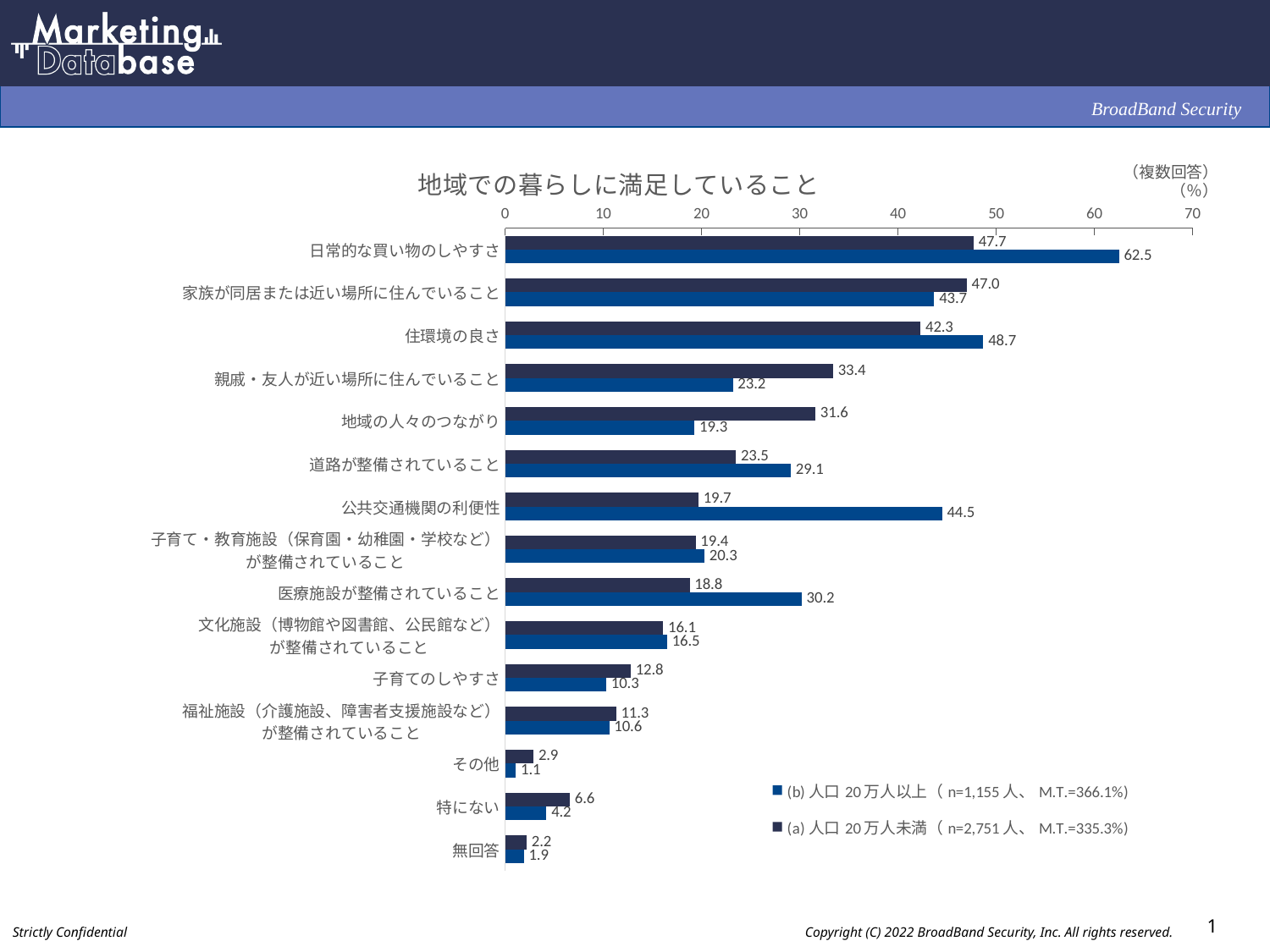
What are the two values shown for 住環境の良さ? 42.3 and 48.7 What is the difference between the two values shown for 日常的な買い物のしやすさ? 14.8 What is the sample size (n) given in the legend for (b) 人口20万人以上? 1,155人 How many series does the legend list? 2 Is the larger of the two values for 親戚・友人が近い場所に住んでいること greater or less than 30? greater Which category has the highest value on the chart? 日常的な買い物のしやすさ What is the title of the chart? 地域での暮らしに満足していること What kind of chart is shown on the slide? Horizontal bar chart How many categories are plotted on the vertical axis? 15 What is the highest value shown on the chart? 62.5 What are the two values shown for 無回答? 2.2 and 1.9 What is the difference between the two values shown for 公共交通機関の利便性? 24.8